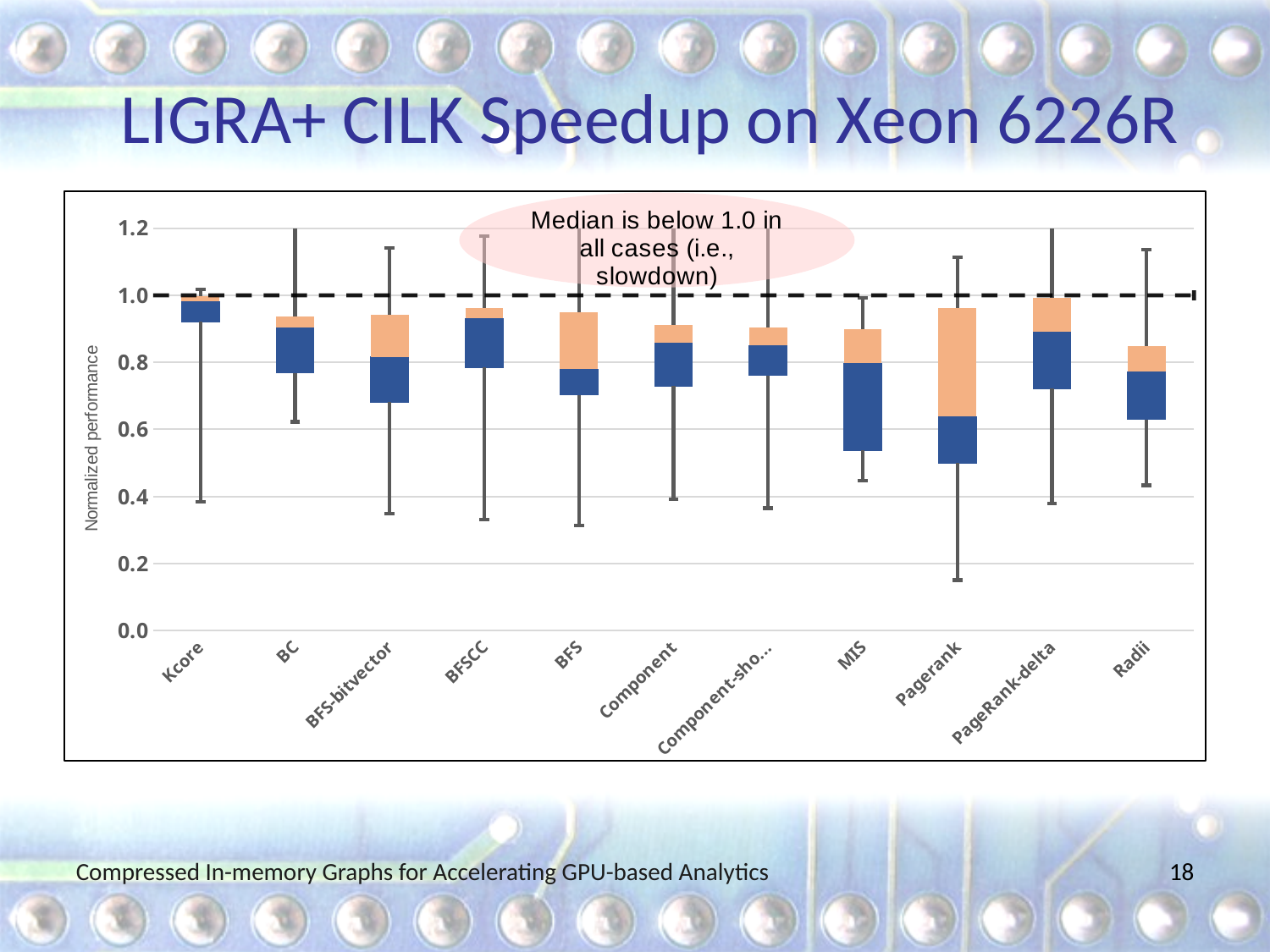
Which has the larger median value, Kcore or Pagerank? Kcore Is the minimum (bottom whisker) value for Pagerank greater or less than 0.2? less Which category has the lowest median value? Pagerank Is the minimum (bottom whisker) value for BFS-bitvector greater or less than 0.4? less Which category has the highest median value? Kcore Is the median value for Kcore greater or less than 0.8? greater What is the title of the slide's chart? LIGRA+ CILK Speedup on Xeon 6226R What is the label of the y axis? Normalized performance Which category has the lowest minimum (bottom whisker) value? Pagerank How many categories are shown along the x axis of the chart? 11 What kind of chart is shown on the slide? Box plot